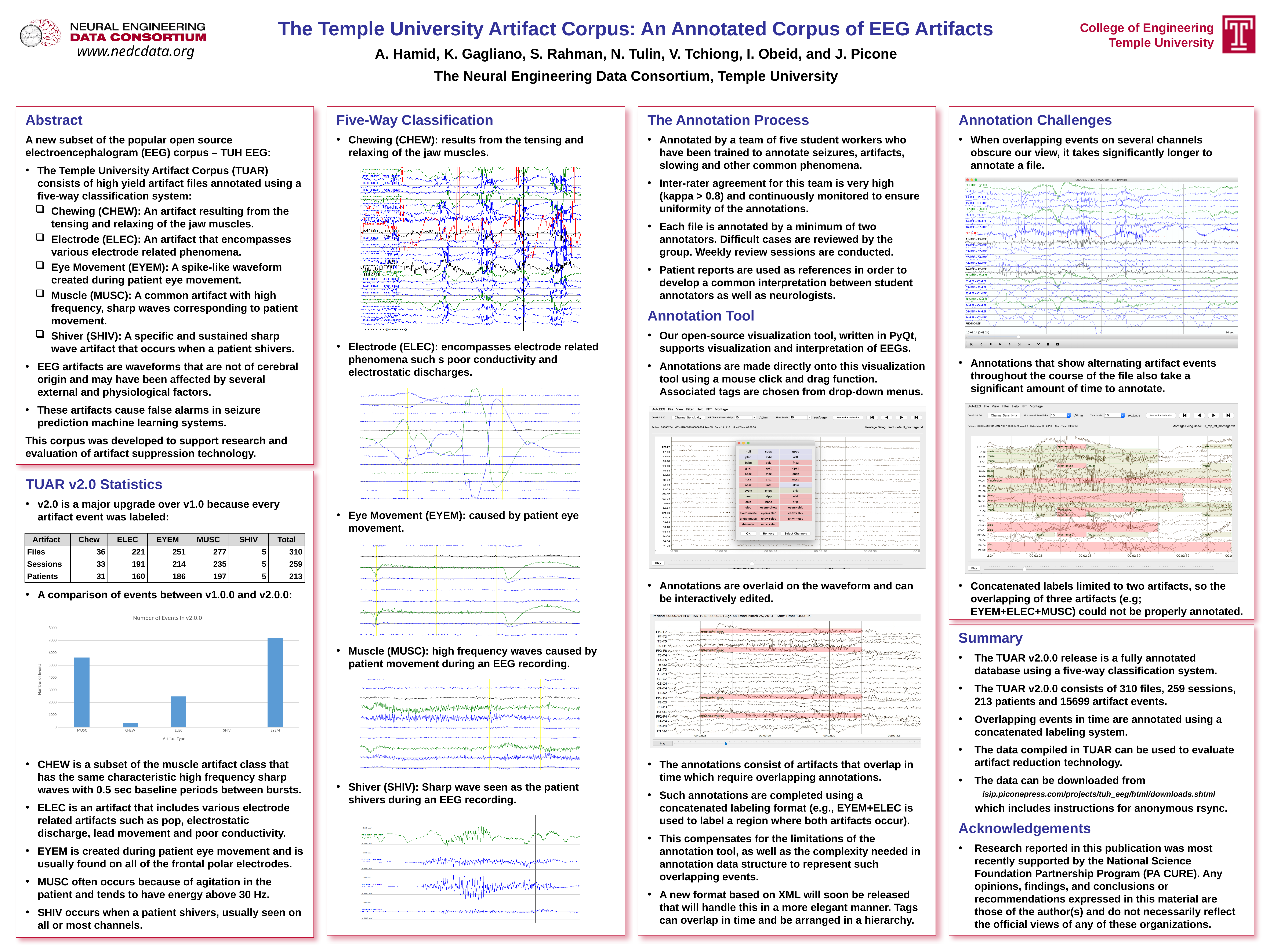
What is the x-axis label of the "Number of Events In v2.0.0" chart? Artifact Type In the "Number of Events In v2.0.0" chart, which has more events, CHEW or ELEC? ELEC In the "Number of Events In v2.0.0" chart, which artifact type has the lowest number of events? SHIV In the "Number of Events In v2.0.0" chart, is the value for MUSC greater or less than 5000? greater What is the y-axis label of the "Number of Events In v2.0.0" chart? Number of Events In the "Number of Events In v2.0.0" chart, which artifact type has the highest number of events? EYEM In the "Number of Events In v2.0.0" chart, is the value for CHEW greater or less than 1000? less What kind of chart is the "Number of Events In v2.0.0" chart? bar chart In the "Number of Events In v2.0.0" chart, which has more events, MUSC or ELEC? MUSC In the "Number of Events In v2.0.0" chart, is the value for EYEM greater or less than 6000? greater How many artifact types are shown on the x axis of the "Number of Events In v2.0.0" chart? 5